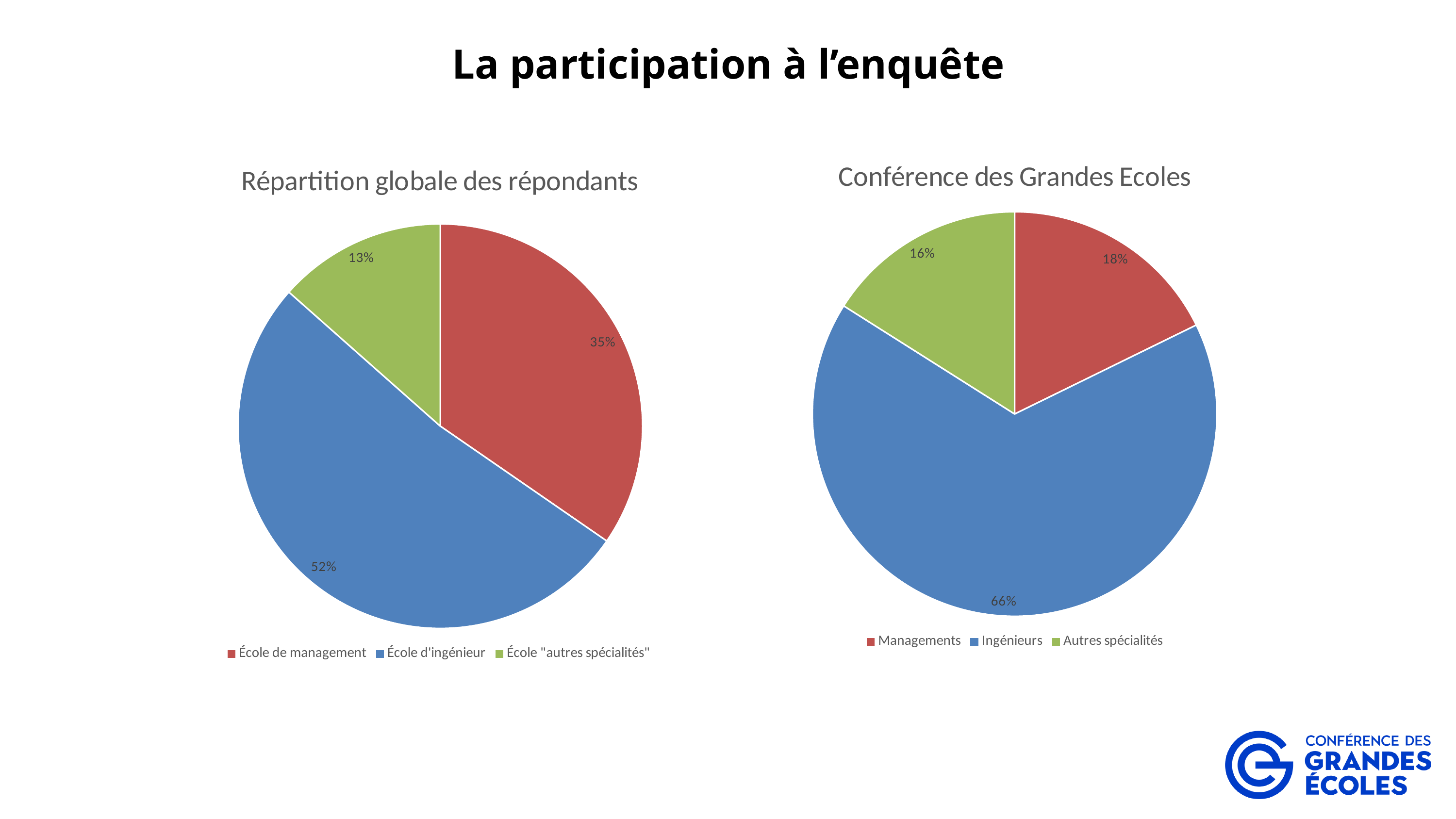
In the 'Conférence des Grandes Ecoles' chart, what share is Managements? 18% In the 'Répartition globale des répondants' chart, which category has the largest slice? École d'ingénieur What type of chart is the 'Répartition globale des répondants' chart? Pie chart In the 'Répartition globale des répondants' chart, what share is École d'ingénieur? 52% How many slices does the 'Conférence des Grandes Ecoles' chart have? 3 In the 'Conférence des Grandes Ecoles' chart, which is larger, Managements or Autres spécialités? Managements In the 'Conférence des Grandes Ecoles' chart, what share is Autres spécialités? 16% In the 'Répartition globale des répondants' chart, what share is École de management? 35% In the 'Conférence des Grandes Ecoles' chart, which category has the smallest slice? Autres spécialités In the 'Conférence des Grandes Ecoles' chart, what share is Ingénieurs? 66% In the 'Répartition globale des répondants' chart, what is the difference between the École de management and École "autres spécialités" shares? 22% In the 'Répartition globale des répondants' chart, what share is École "autres spécialités"? 13%